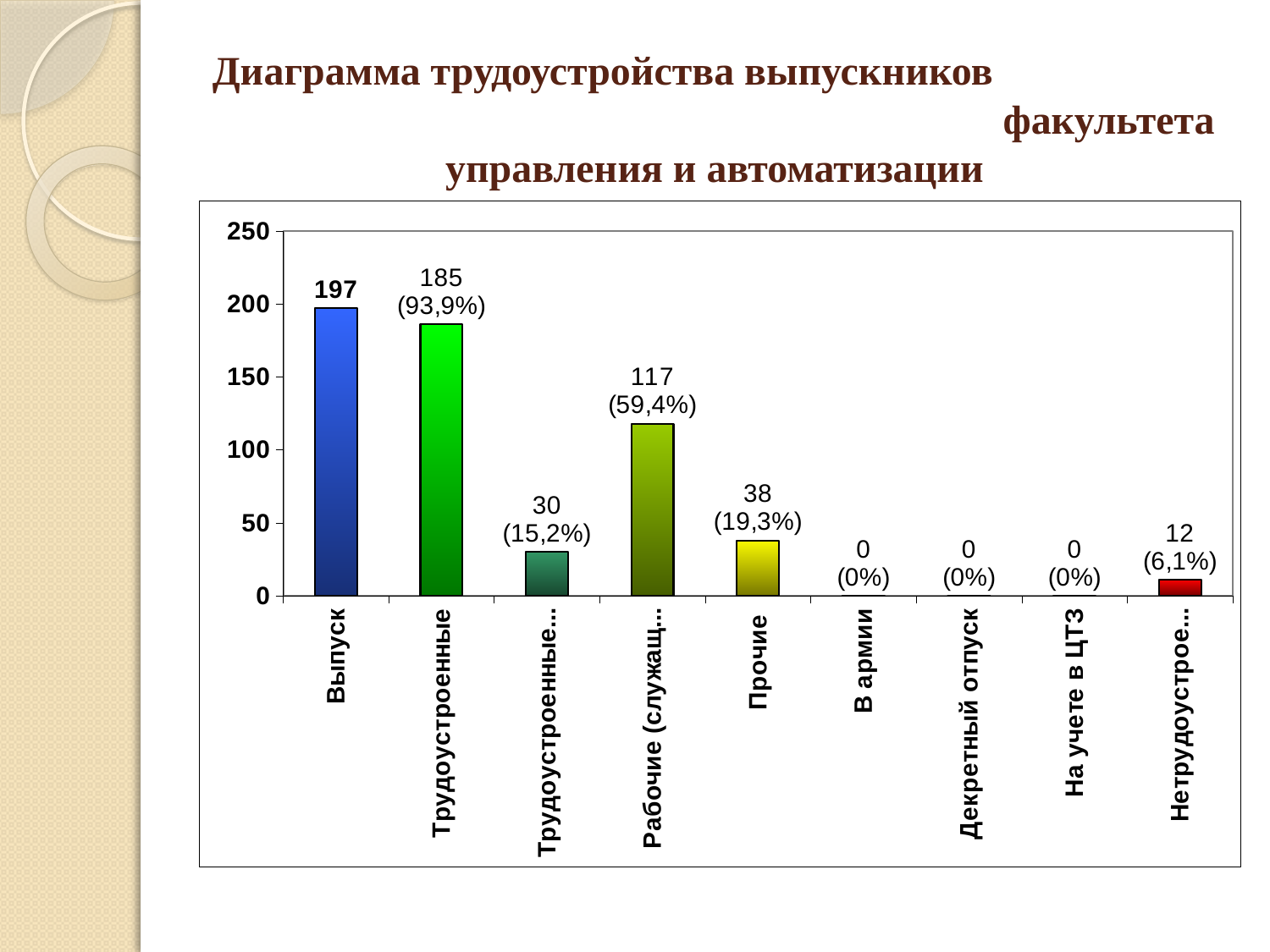
Which category has the highest value? Выпуск Which is larger, the value for Прочие or the value for На учете в ЦТЗ? Прочие What is the value for Прочие? 38 What is the value for Трудоустроенные? 185 What is the value for Выпуск? 197 What is the value for Декретный отпуск? 0 What percentage is shown in the data label for Трудоустроенные? 93,9% What is the value for В армии? 0 What is the difference between the values for Выпуск and Трудоустроенные? 12 How many categories are shown on the x axis? 9 What is the value of the rightmost (red) bar? 12 What kind of chart is shown on the slide? bar chart